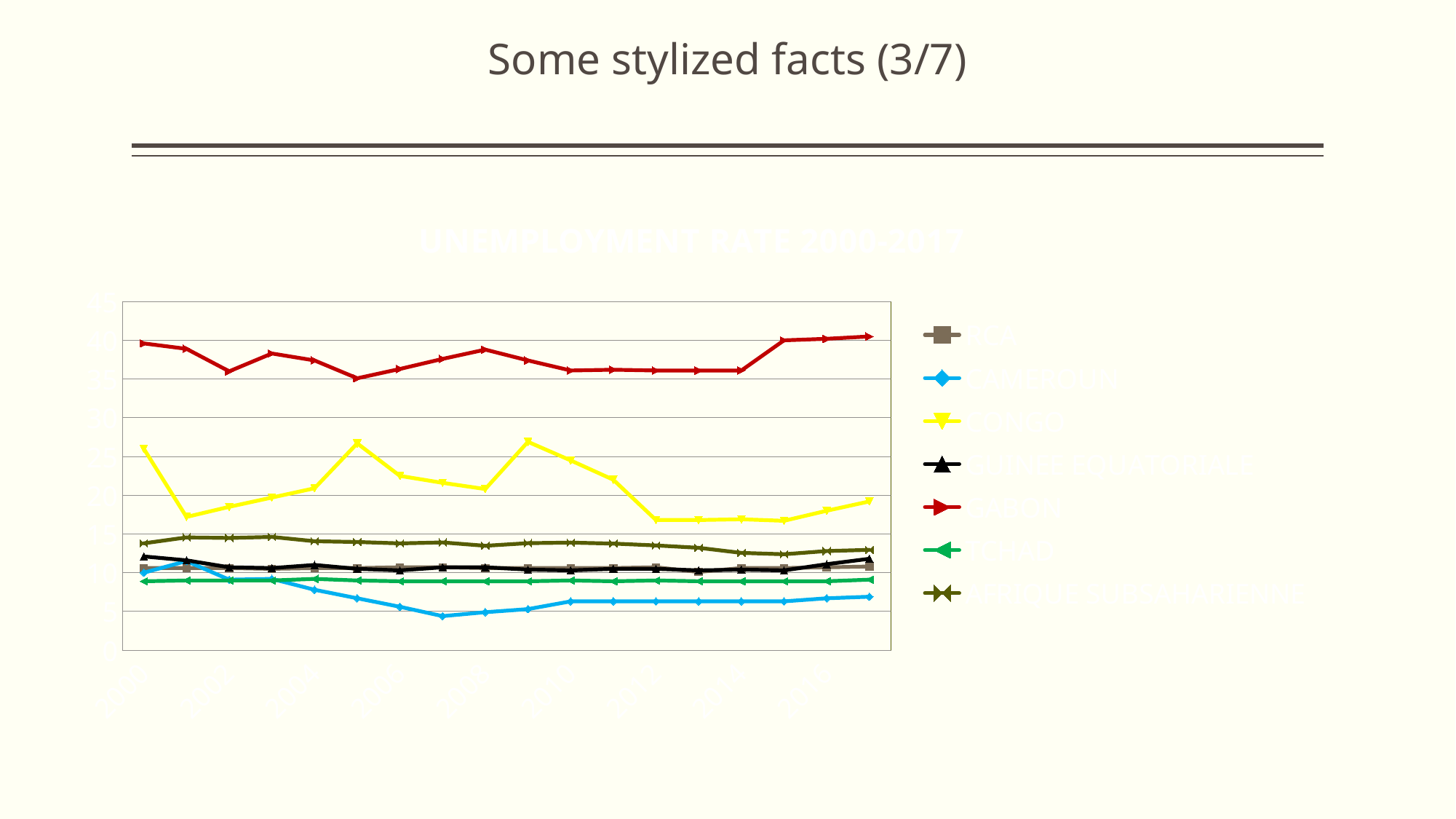
Is the yellow line above or below the red line? below How many data points does each line in the chart have? 18 Which coloured line reaches the lowest point on the chart? the blue line Is the olive (dark yellow) line with x markers above or below the black line? above Does the yellow line end higher or lower than it starts? lower Which colour is the line with the second-highest values on the chart? yellow What is the title of the chart? UNEMPLOYMENT RATE 2000-2017 At the right end of the chart, is the green line above or below the blue line? above Does the blue line end higher or lower than it starts? lower What kind of chart is shown on the slide? line chart How many series does the chart's legend list? 7 Which coloured line has the highest values across the whole chart? the red line